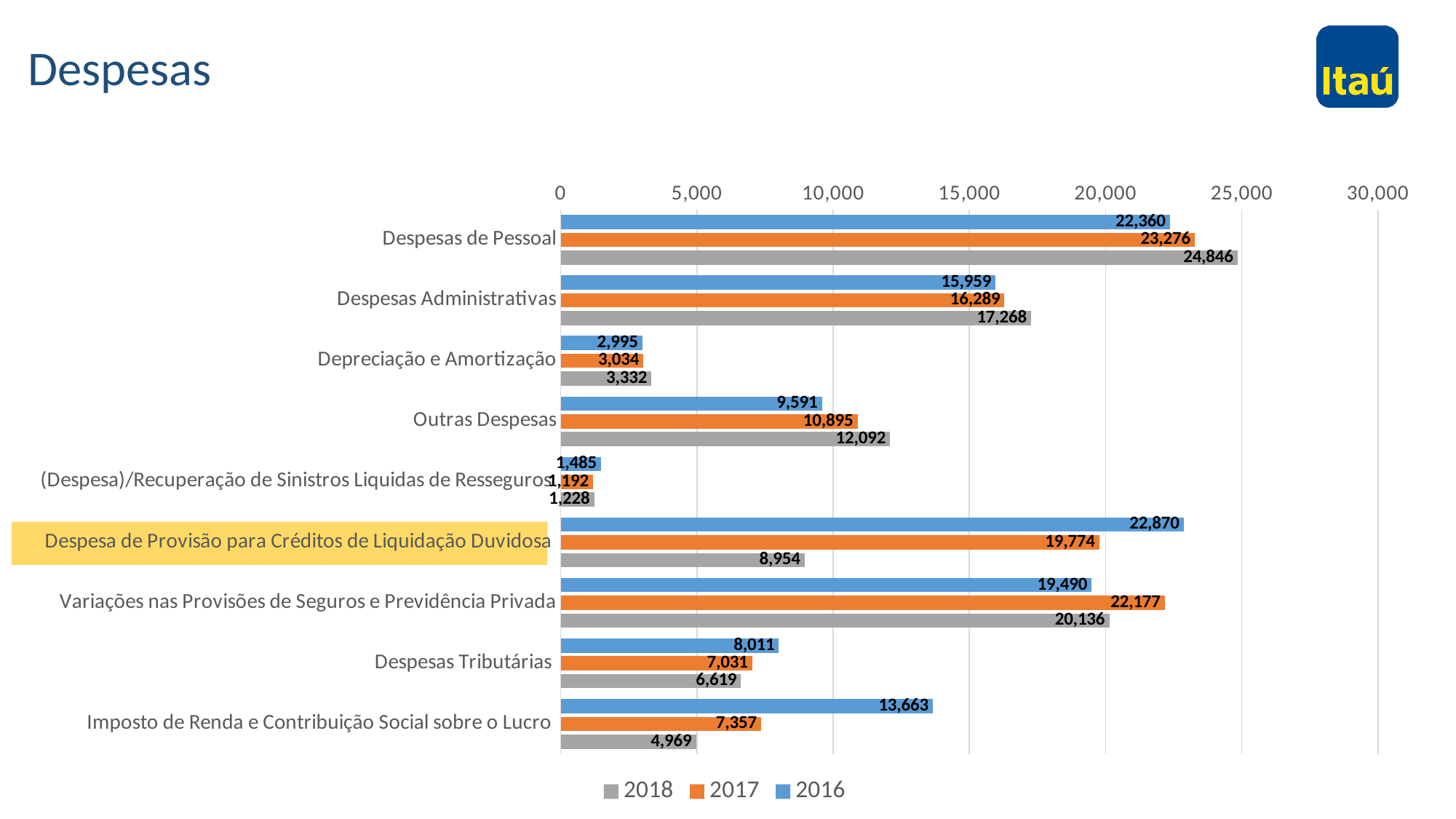
What is the difference between the 2017 and 2018 values for Despesa de Provisão para Créditos de Liquidação Duvidosa? 10,820 What is the 2017 value for Imposto de Renda e Contribuição Social sobre o Lucro? 7,357 For Despesas Tributárias, which year has the larger value, 2016 or 2018? 2016 Which category label is highlighted in yellow on the chart? Despesa de Provisão para Créditos de Liquidação Duvidosa Which category has the lowest 2017 value? (Despesa)/Recuperação de Sinistros Liquidas de Resseguros What is the difference between the 2016 and 2018 values for Imposto de Renda e Contribuição Social sobre o Lucro? 8,694 Which category has the highest 2018 value? Despesas de Pessoal How many expense categories are shown on the chart? 9 What is the 2016 value for Despesa de Provisão para Créditos de Liquidação Duvidosa? 22,870 How many series does the legend list? 3 What is the 2018 value for Despesas de Pessoal? 24,846 What kind of chart is shown on the slide? Bar chart